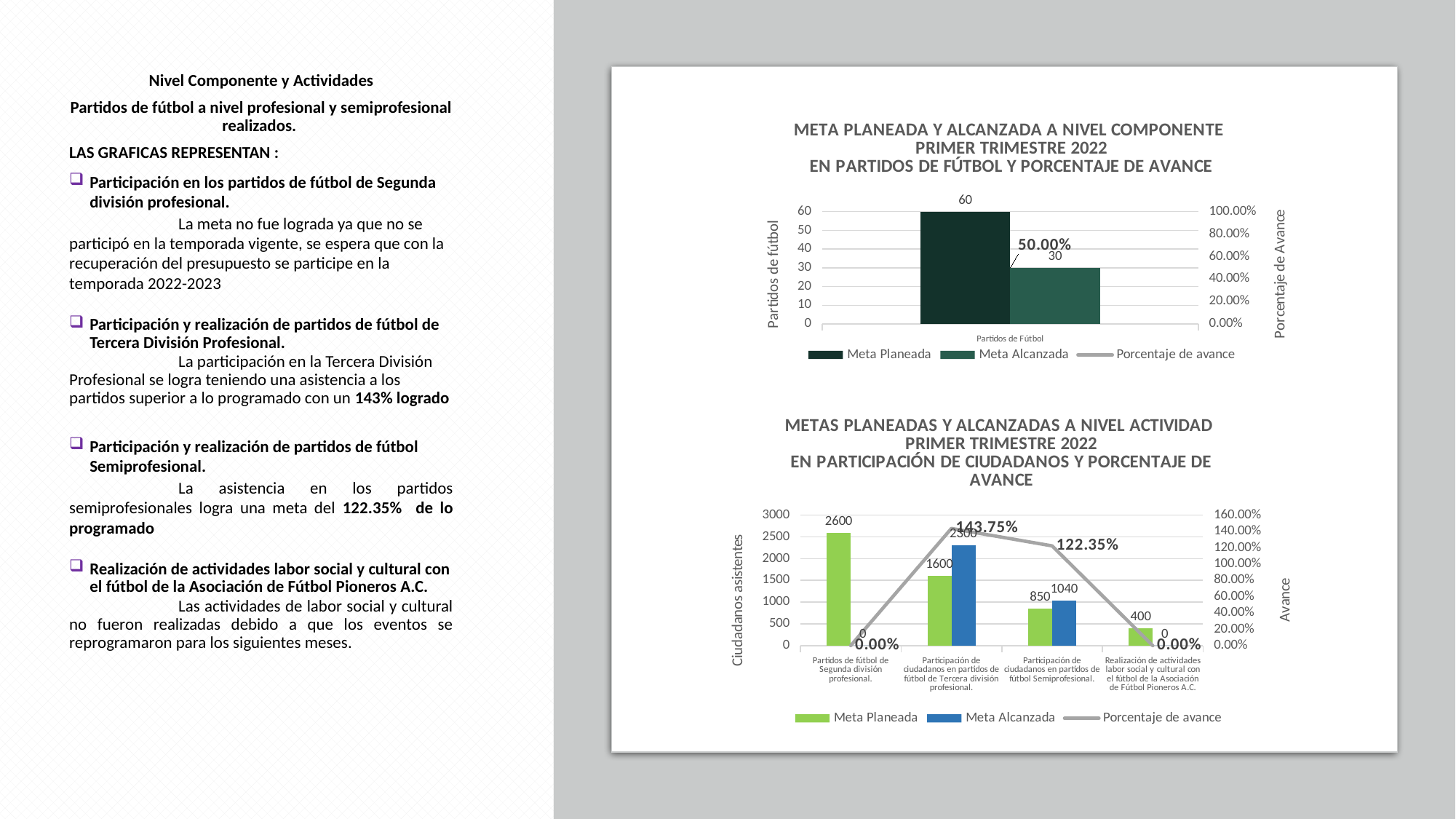
In the bottom chart (Metas planeadas y alcanzadas a nivel actividad), which category has the highest Meta Planeada? Partidos de fútbol de Segunda división profesional. In the top chart (Meta planeada y alcanzada a nivel componente), what is the value of Meta Planeada for Partidos de Fútbol? 60 In the bottom chart (Metas planeadas y alcanzadas a nivel actividad), how many categories are shown on the x axis? 4 In the top chart (Meta planeada y alcanzada a nivel componente), what is the Porcentaje de avance shown? 50.00% In the bottom chart (Metas planeadas y alcanzadas a nivel actividad), what is the difference between Meta Alcanzada and Meta Planeada for Participación de ciudadanos en partidos de fútbol Semiprofesional? 190 In the top chart (Meta planeada y alcanzada a nivel componente), what is the value of Meta Alcanzada? 30 In the top chart (Meta planeada y alcanzada a nivel componente), how many series does the legend list? 3 In the bottom chart (Metas planeadas y alcanzadas a nivel actividad), what is the Porcentaje de avance for Participación de ciudadanos en partidos de fútbol Semiprofesional? 122.35% In the bottom chart (Metas planeadas y alcanzadas a nivel actividad), which is larger for Tercera división profesional: Meta Planeada or Meta Alcanzada? Meta Alcanzada In the bottom chart (Metas planeadas y alcanzadas a nivel actividad), what is the Meta Planeada for Partidos de fútbol de Segunda división profesional? 2600 In the top chart (Meta planeada y alcanzada a nivel componente), what is the difference between Meta Planeada and Meta Alcanzada? 30 In the bottom chart (Metas planeadas y alcanzadas a nivel actividad), what is the Meta Alcanzada for Participación de ciudadanos en partidos de fútbol de Tercera división profesional? 2300